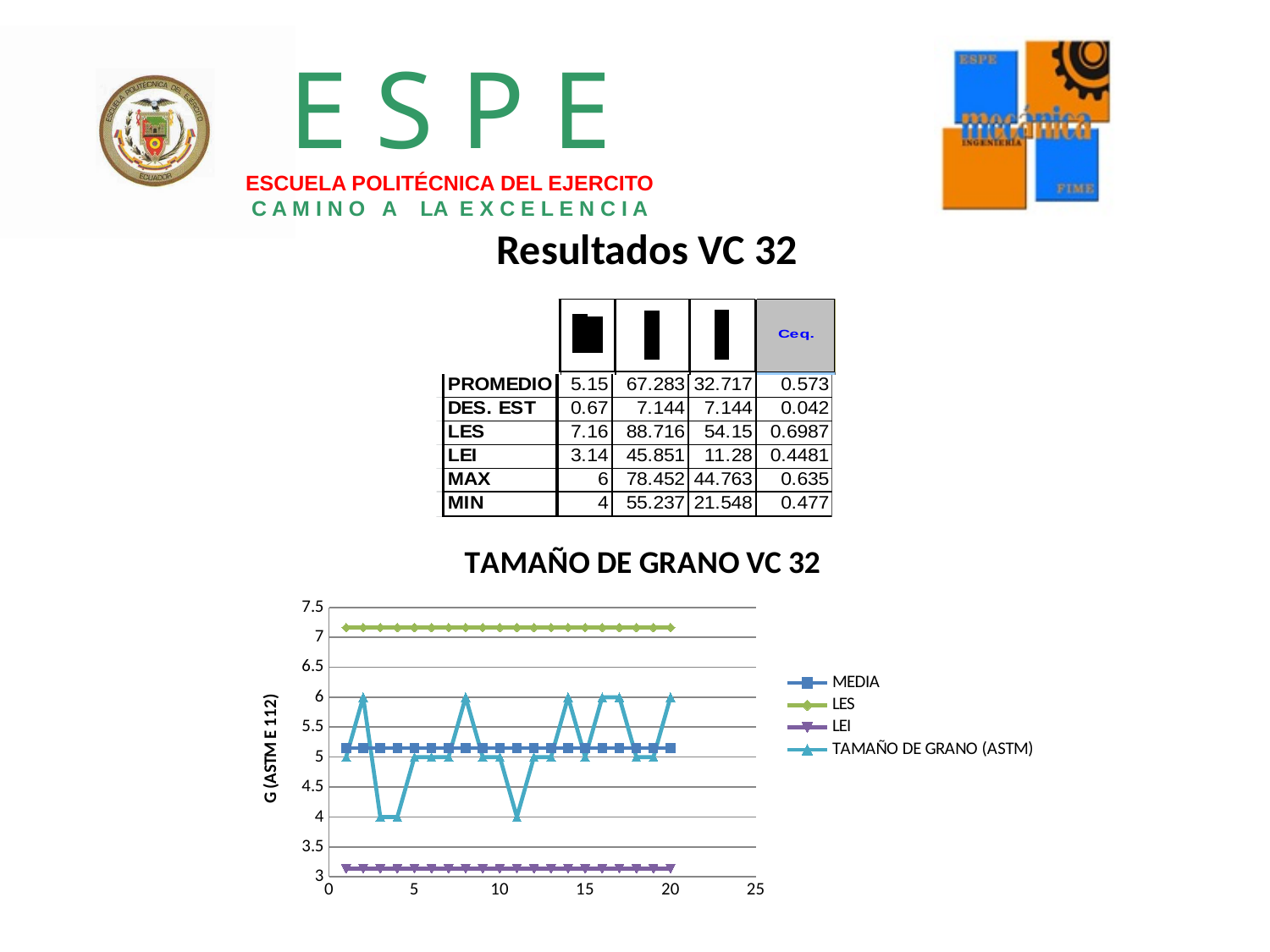
How many series does the legend of the 'TAMAÑO DE GRANO VC 32' chart list? 4 What kind of chart is 'TAMAÑO DE GRANO VC 32'? line chart In the 'TAMAÑO DE GRANO VC 32' chart, is the LES line greater or less than 7? greater In the 'TAMAÑO DE GRANO VC 32' chart, which line is higher, LES or LEI? LES In the 'TAMAÑO DE GRANO VC 32' chart, is the MEDIA line greater or less than 5.5? less In the 'TAMAÑO DE GRANO VC 32' chart, does the LES line rise, fall, or stay flat along the x axis? stays flat How many data points does the TAMAÑO DE GRANO (ASTM) series have in the 'TAMAÑO DE GRANO VC 32' chart? 20 In the 'TAMAÑO DE GRANO VC 32' chart, which series has the lowest values? LEI In the 'TAMAÑO DE GRANO VC 32' chart, is the LEI line greater or less than 3.5? less In the 'TAMAÑO DE GRANO VC 32' chart, which series has the highest values? LES What is the label of the vertical axis in the 'TAMAÑO DE GRANO VC 32' chart? G (ASTM E 112) What is the title of the chart on the slide? TAMAÑO DE GRANO VC 32